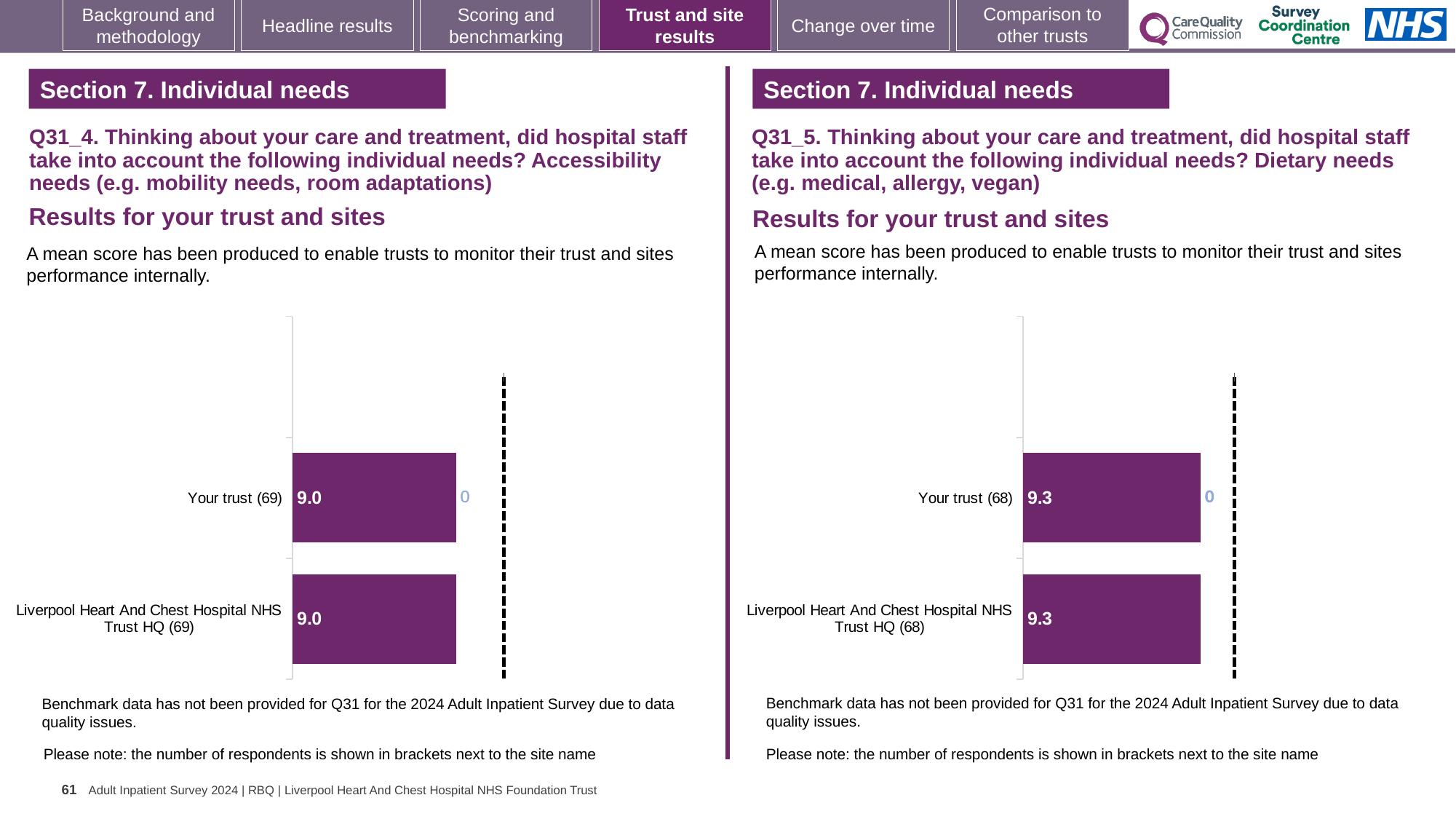
How many bars are plotted in the left chart (Q31_4, accessibility needs)? 2 What kind of chart is used in the left chart (Q31_4, accessibility needs)? Bar chart How many bars are plotted in the right chart (Q31_5, dietary needs)? 2 In the left chart (Q31_4, accessibility needs), what is the mean score for Liverpool Heart And Chest Hospital NHS Trust HQ? 9.0 Is the Your trust score in the right chart (Q31_5, dietary needs) larger or smaller than the Your trust score in the left chart (Q31_4, accessibility needs)? Larger In the right chart (Q31_5, dietary needs), what is the difference between the score for Your trust and the score for Liverpool Heart And Chest Hospital NHS Trust HQ? 0.0 In the right chart (Q31_5, dietary needs), how many respondents are shown in brackets for Liverpool Heart And Chest Hospital NHS Trust HQ? 68 In the left chart (Q31_4, accessibility needs), how many respondents are shown in brackets for Your trust? 69 In the right chart (Q31_5, dietary needs), what is the mean score for Your trust? 9.3 In the right chart (Q31_5, dietary needs), what is the mean score for Liverpool Heart And Chest Hospital NHS Trust HQ? 9.3 In the left chart (Q31_4, accessibility needs), what is the difference between the score for Your trust and the score for Liverpool Heart And Chest Hospital NHS Trust HQ? 0.0 In the left chart (Q31_4, accessibility needs), what is the mean score for Your trust? 9.0